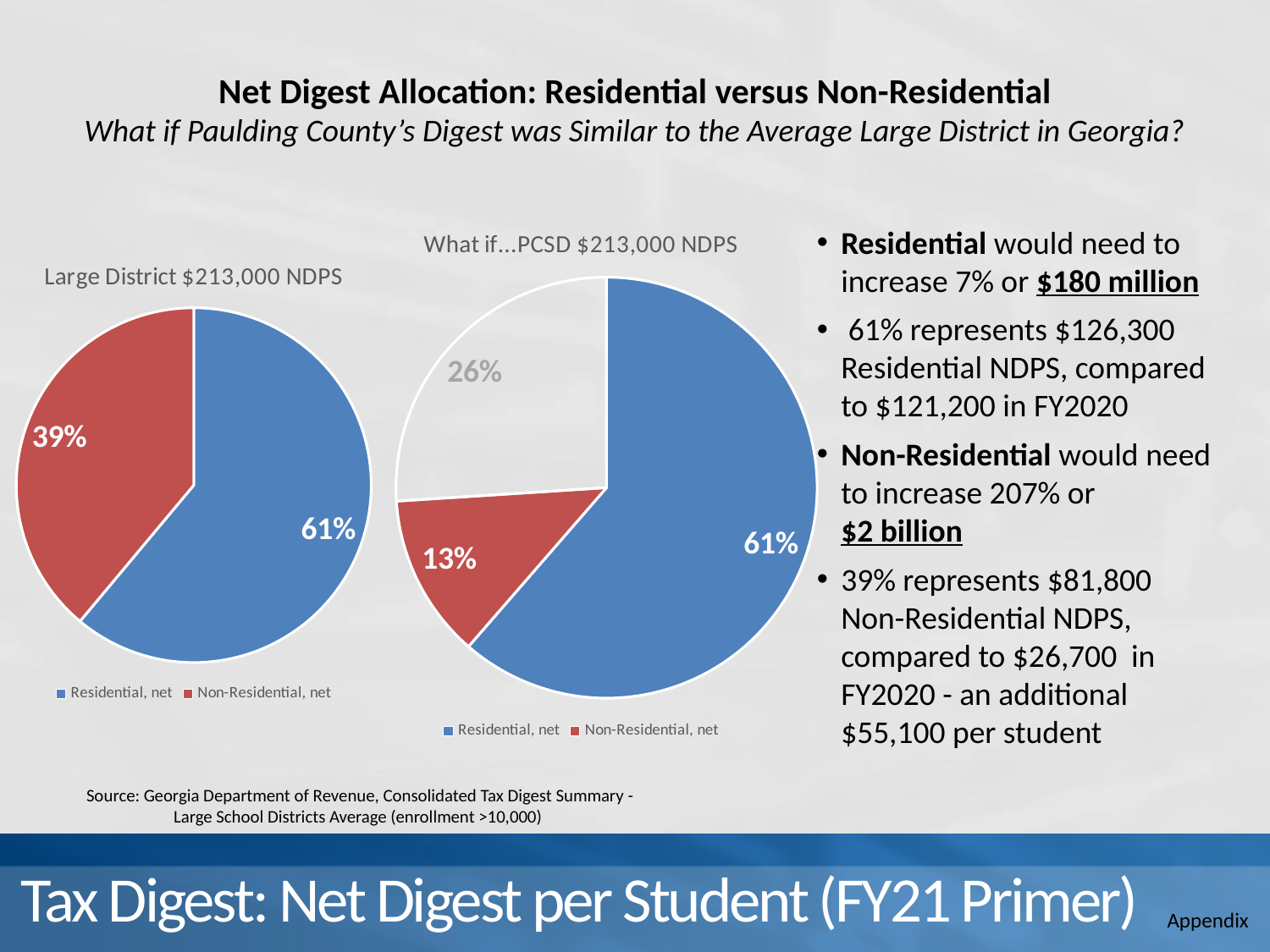
In the 'Large District $213,000 NDPS' chart, what share does Residential, net have? 61% In the 'What if...PCSD $213,000 NDPS' chart, what colour is the Residential, net slice? Blue In the 'Large District $213,000 NDPS' chart, what is the difference between the Residential, net and Non-Residential, net shares? 22% In the 'Large District $213,000 NDPS' chart, what share does Non-Residential, net have? 39% In the 'What if...PCSD $213,000 NDPS' chart, what share does Residential, net have? 61% In the 'Large District $213,000 NDPS' chart, which slice is the largest? Residential, net How many entries does the legend of the 'Large District $213,000 NDPS' chart list? 2 Which chart shows a larger share for Non-Residential, net: 'Large District $213,000 NDPS' or 'What if...PCSD $213,000 NDPS'? Large District $213,000 NDPS In the 'What if...PCSD $213,000 NDPS' chart, what percentage is shown on the grey slice? 26% In the 'What if...PCSD $213,000 NDPS' chart, which slice is the smallest? Non-Residential, net In the 'What if...PCSD $213,000 NDPS' chart, what share does Non-Residential, net have? 13% What type of chart is the 'Large District $213,000 NDPS' chart? Pie chart